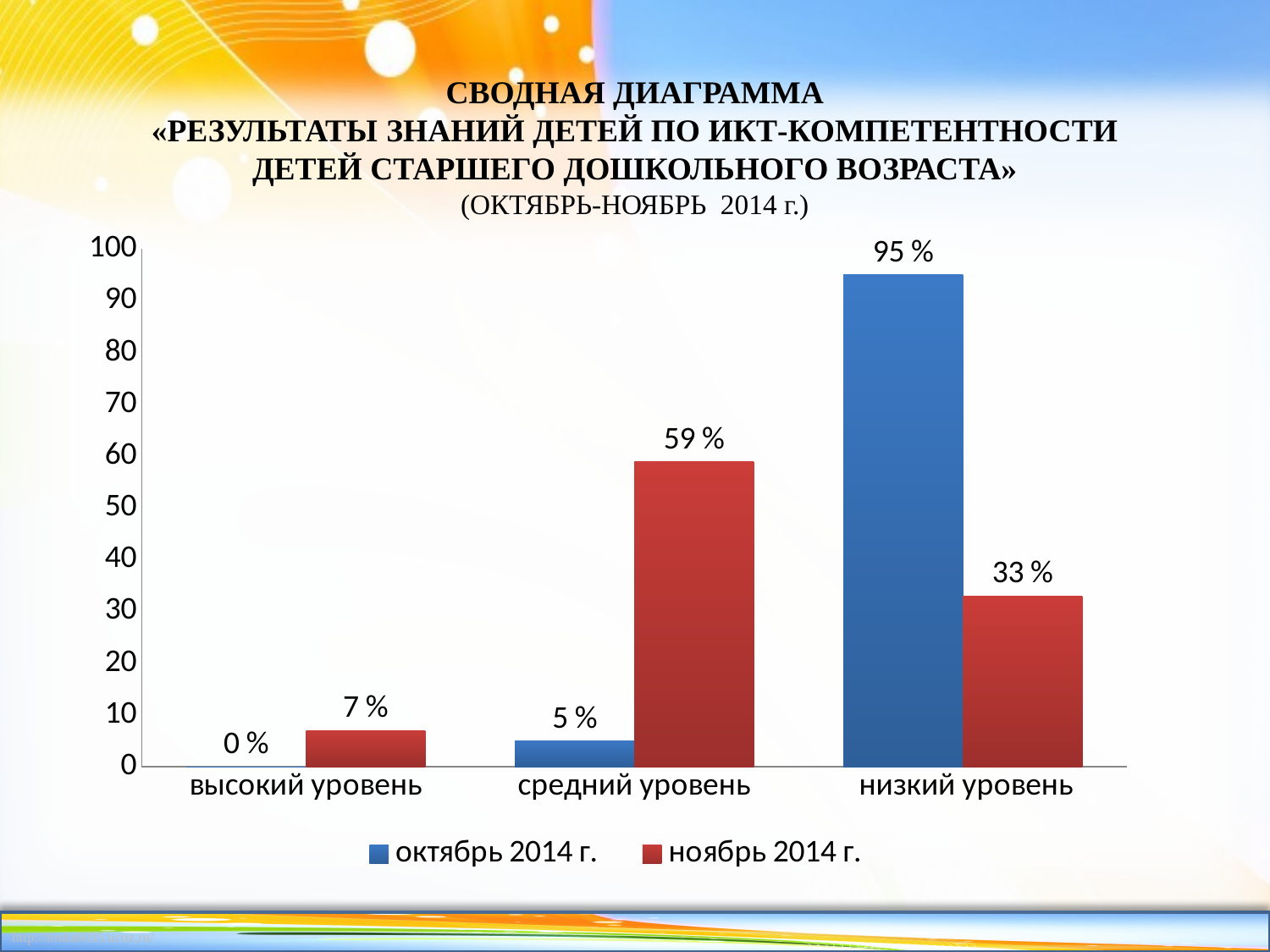
What is the value for высокий уровень in октябрь 2014 г.? 0 % Which category has the lowest value for октябрь 2014 г.? высокий уровень What is the difference between the октябрь 2014 г. and ноябрь 2014 г. values for низкий уровень? 62 % What is the value for низкий уровень in ноябрь 2014 г.? 33 % How many categories are shown on the x axis? 3 What is the value for низкий уровень in октябрь 2014 г.? 95 % What kind of chart is shown on the slide? bar chart What is the value for средний уровень in ноябрь 2014 г.? 59 % Which category has the highest value for ноябрь 2014 г.? средний уровень How many series does the legend list? 2 Which is larger for средний уровень: the октябрь 2014 г. value or the ноябрь 2014 г. value? ноябрь 2014 г. Which colour represents ноябрь 2014 г. in the chart? red